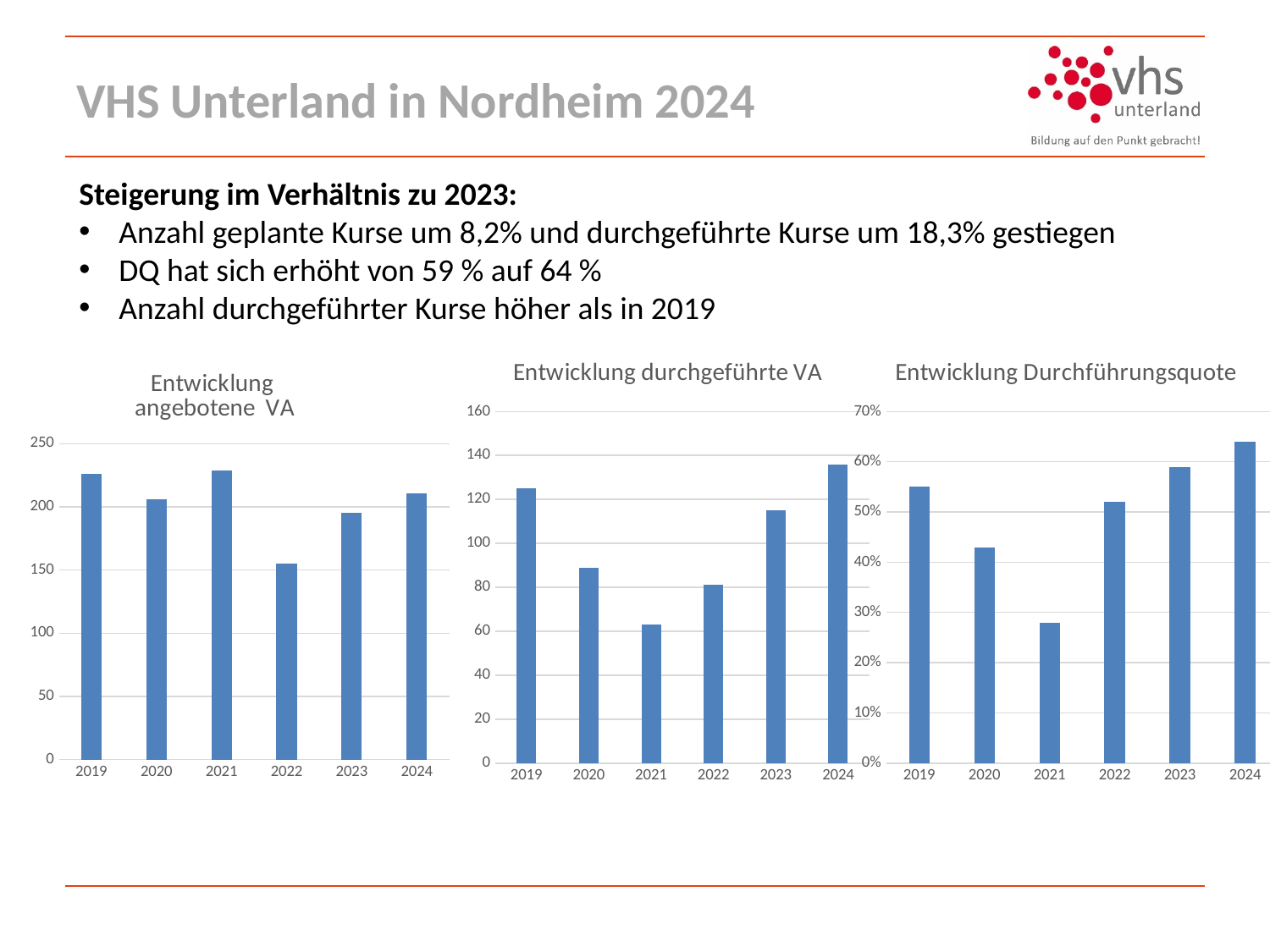
In the chart titled 'Entwicklung durchgeführte VA', which year has the lowest value? 2021 In the chart titled 'Entwicklung angebotene VA', is the value for 2019 greater or less than 200? greater In the chart titled 'Entwicklung Durchführungsquote', which year has the highest value? 2024 How many years are shown on the x axis of the chart titled 'Entwicklung durchgeführte VA'? 6 In the chart titled 'Entwicklung durchgeführte VA', is the value for 2024 greater or less than 120? greater In the chart titled 'Entwicklung angebotene VA', is the value for 2022 greater or less than 200? less In the chart titled 'Entwicklung Durchführungsquote', which year has the lowest value? 2021 In the chart titled 'Entwicklung Durchführungsquote', which is larger, the value for 2023 or the value for 2020? 2023 In the chart titled 'Entwicklung angebotene VA', which year has the lowest value? 2022 In the chart titled 'Entwicklung durchgeführte VA', which year has the highest value? 2024